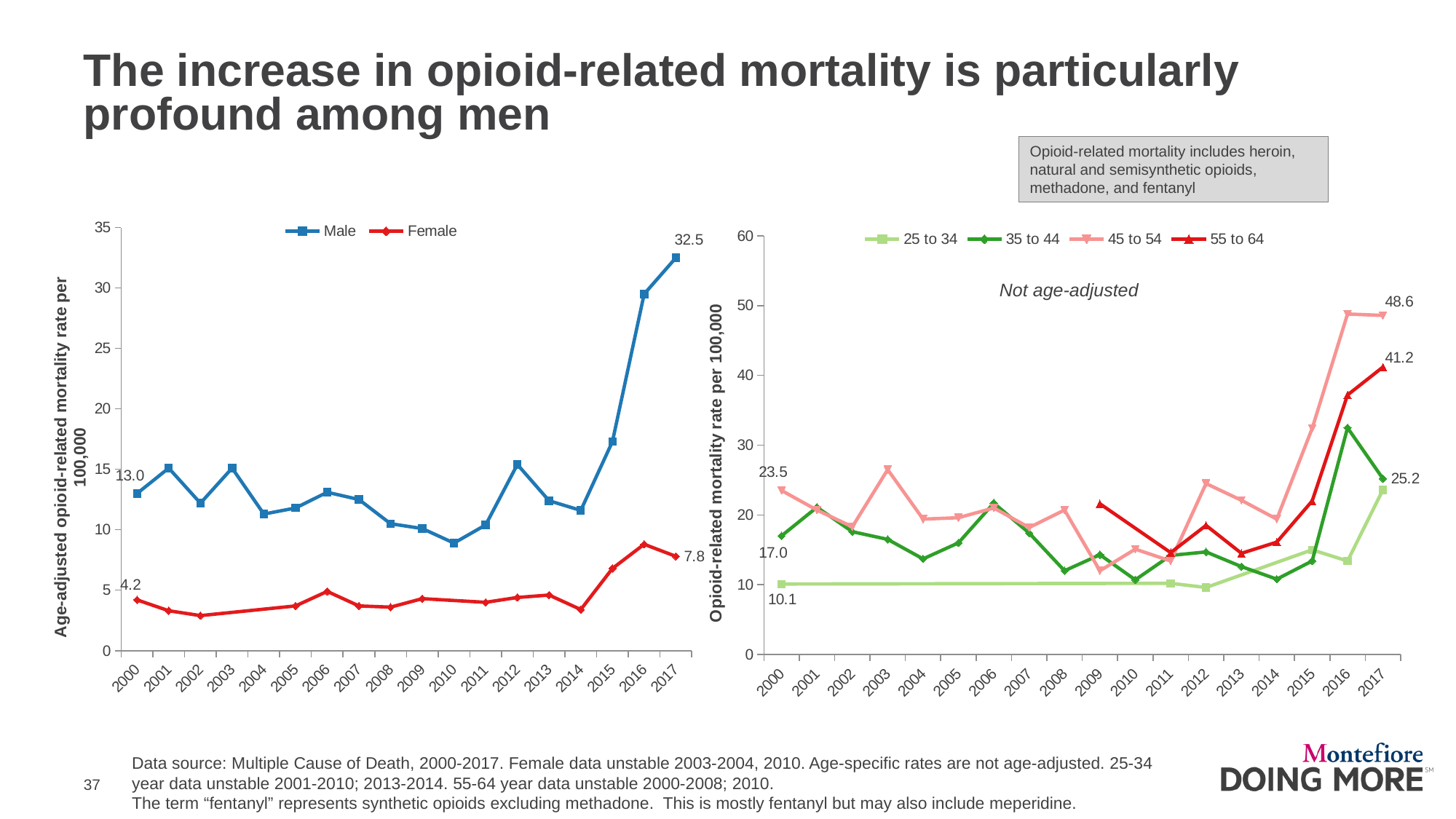
In the left chart, what is the age-adjusted opioid-related mortality rate for males in 2017? 32.5 In the left chart, what is the age-adjusted opioid-related mortality rate for females in 2000? 4.2 What type of chart is the right chart? Line chart In the right chart, what is the opioid-related mortality rate for the 45 to 54 age group in 2017? 48.6 In the right chart, which age group has the highest value in 2017? 45 to 54 In the left chart, is the male value for 2016 greater or less than 25? greater In the right chart, what is the difference between the 45 to 54 rate in 2017 and in 2000? 25.1 In the left chart, what is the difference between the male rate in 2017 and the male rate in 2000? 19.5 In the right chart, what is the opioid-related mortality rate for the 55 to 64 age group in 2017? 41.2 How many years are shown on the x axis of the right chart? 18 In the left chart, which series has the higher value in 2017, Male or Female? Male How many series does the legend of the left chart list? 2